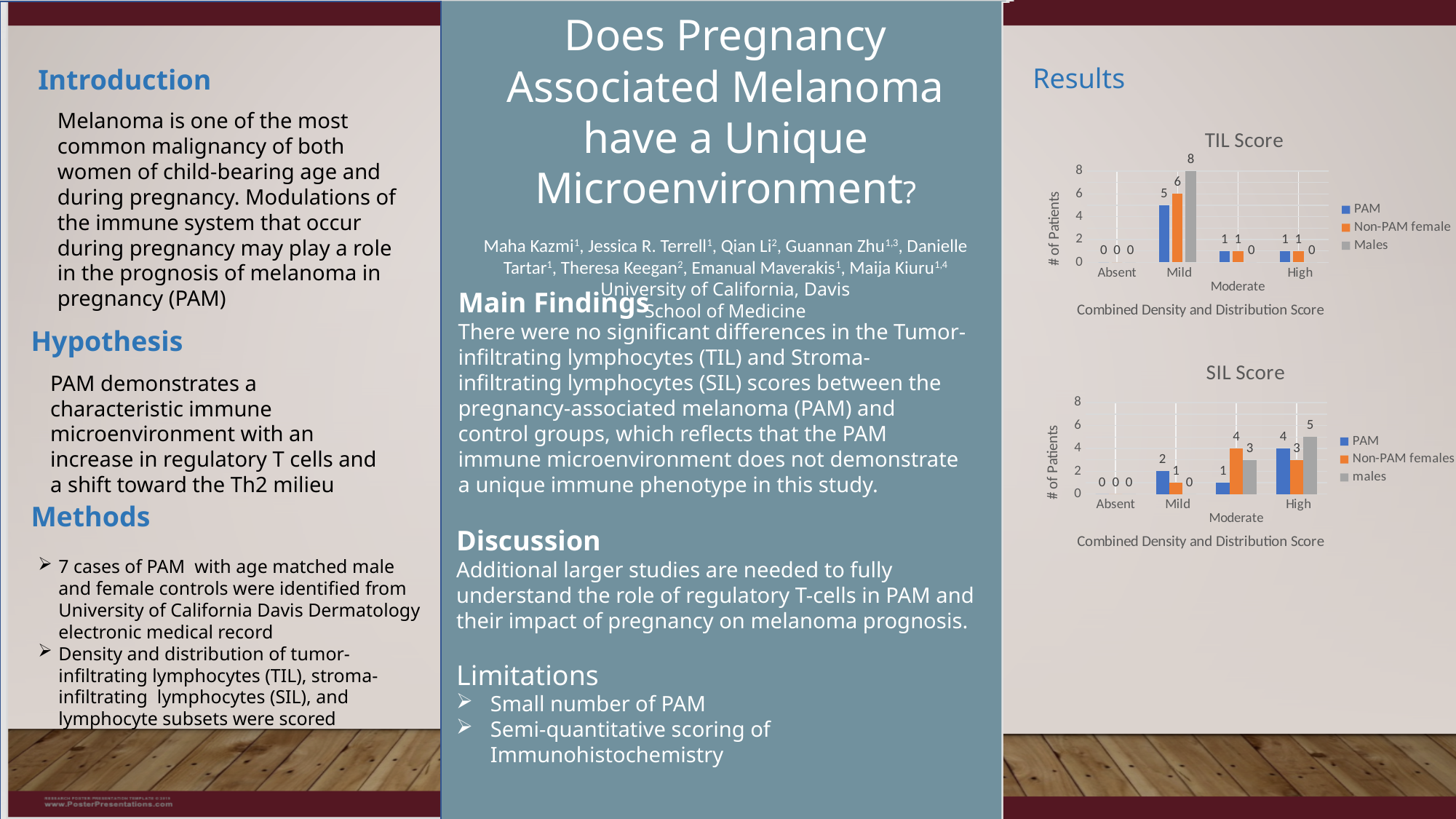
In the SIL Score chart, what is the value for males in the High category? 5 In the TIL Score chart, which category has the highest value for Non-PAM female? Mild In the TIL Score chart, how many patients in the Males series have a Mild score? 8 In the SIL Score chart, what is the value for Non-PAM females in the Moderate category? 4 In the TIL Score chart, what is the value for PAM in the Mild category? 5 In the SIL Score chart, which is larger in the Moderate category: PAM or males? males What kind of chart is the TIL Score chart? Bar chart In the TIL Score chart, how many series does the legend list? 3 In the SIL Score chart, which category has the highest value for PAM? High In the SIL Score chart, what is the difference between the PAM and Non-PAM females values in the Mild category? 1 In the TIL Score chart, what is the difference between the Males and PAM values in the Mild category? 3 How many categories are shown on the x axis of the SIL Score chart? 4